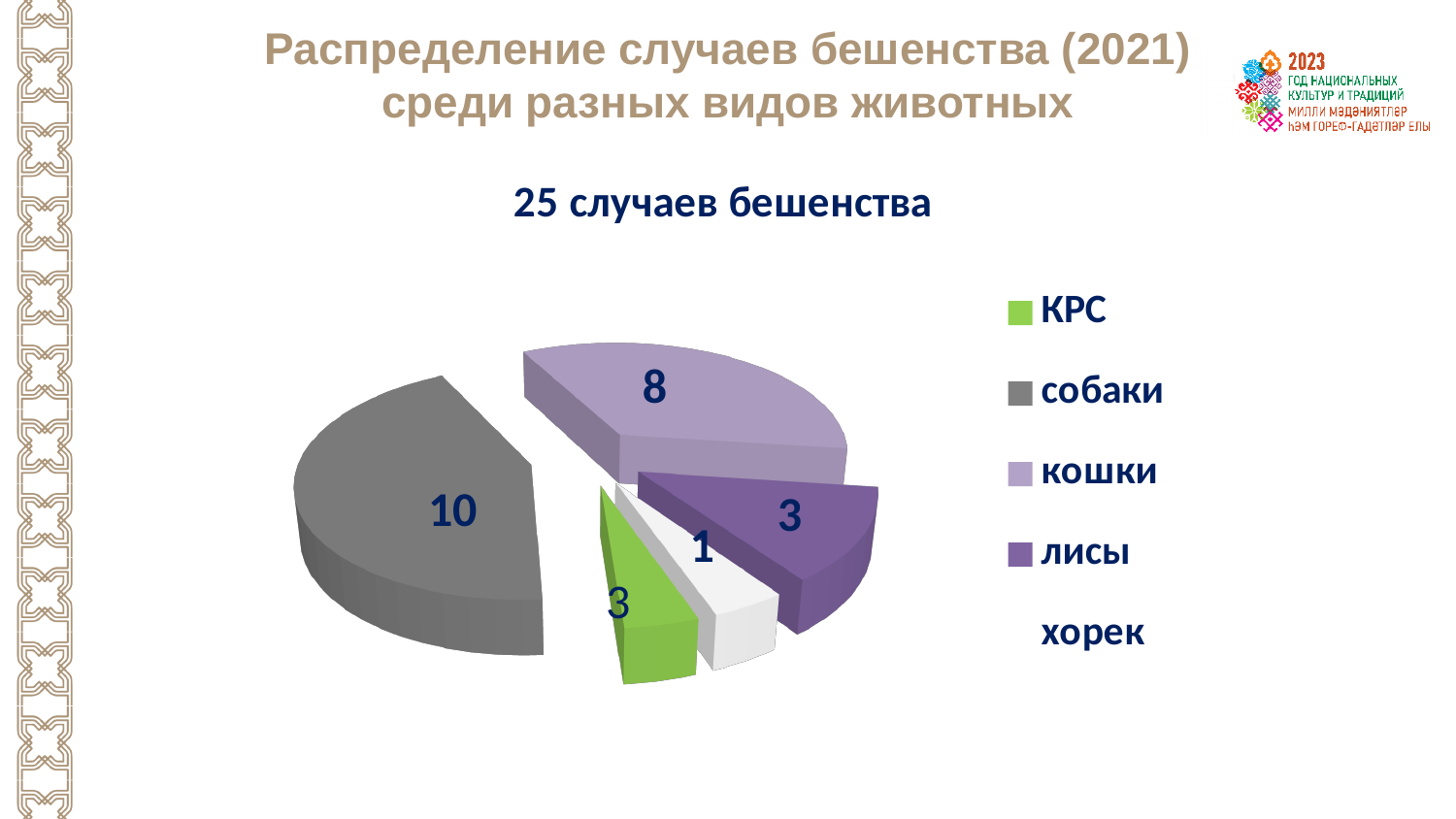
Which animal category has the smallest number of rabies cases? хорек What is the title of the chart? 25 случаев бешенства What is the difference between the number of cases for собаки and кошки? 2 Which has more rabies cases, кошки or лисы? кошки How many animal categories does the legend list? 5 How many cases of rabies are attributed to хорек? 1 How many cases of rabies are attributed to кошки? 8 What kind of chart is shown on the slide? pie chart What share of the 25 rabies cases is attributed to собаки? 40% How many cases of rabies are attributed to лисы? 3 Which animal category has the largest number of rabies cases? собаки How many cases of rabies are attributed to собаки? 10